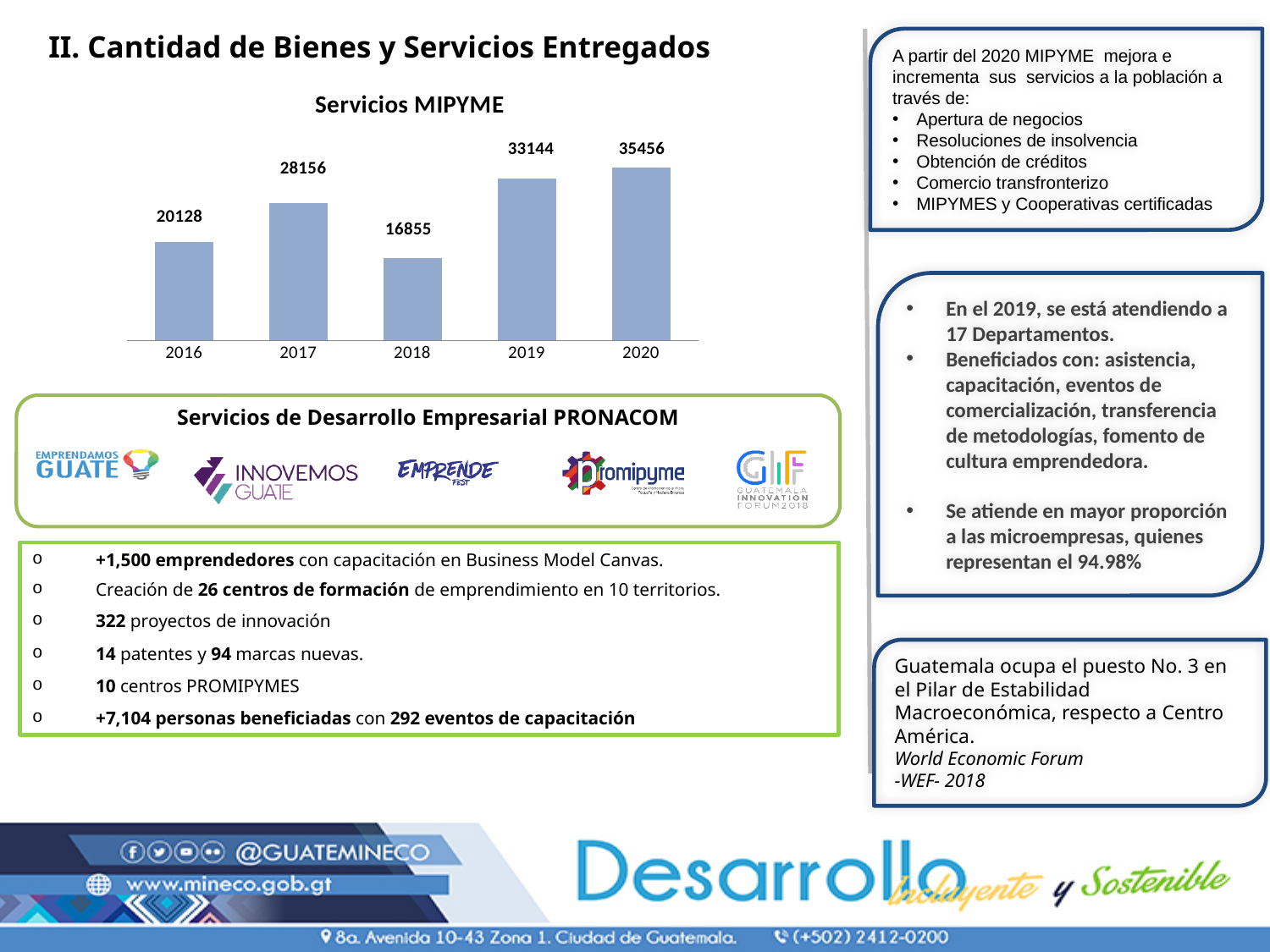
Which year has the lowest value in the Servicios MIPYME chart? 2018 Which is larger in the Servicios MIPYME chart, the value for 2017 or the value for 2018? 2017 In the Servicios MIPYME chart, do the values rise or fall from 2018 to 2020? Rise What is the title of the chart on the slide? Servicios MIPYME What is the difference between the 2017 and 2016 values in the Servicios MIPYME chart? 8028 What kind of chart is the Servicios MIPYME chart? Bar chart What is the value for 2020 in the Servicios MIPYME chart? 35456 How many years are shown in the Servicios MIPYME chart? 5 What is the value for 2016 in the Servicios MIPYME chart? 20128 What is the value for 2018 in the Servicios MIPYME chart? 16855 Which year has the highest value in the Servicios MIPYME chart? 2020 What is the difference between the 2020 and 2019 values in the Servicios MIPYME chart? 2312